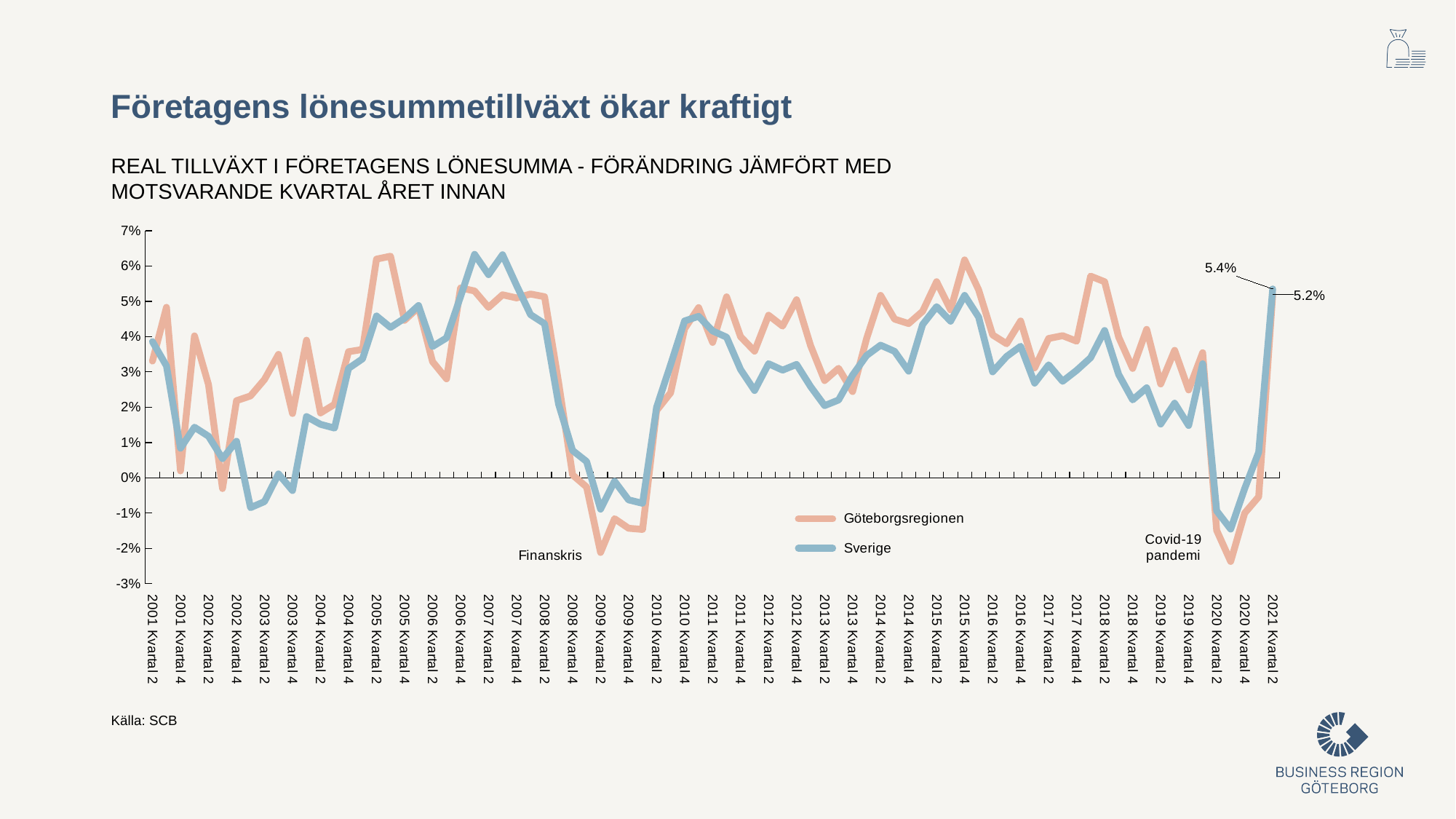
At 2020 Kvartal 2, which series has the lower value, Göteborgsregionen or Sverige? Göteborgsregionen Is the value for Sverige at 2020 Kvartal 2 greater or less than 0%? less What is the higher of the two values labelled at the end of the lines (2021 Kvartal 2)? 5.4% What kind of chart is shown on the slide? Line chart Is the value for Göteborgsregionen at 2020 Kvartal 2 greater or less than 0%? less How many series does the legend list? 2 What two events are annotated on the chart? Finanskris and Covid-19 pandemi What is the lower of the two values labelled at the end of the lines (2021 Kvartal 2)? 5.2% Is the value for Göteborgsregionen at 2009 Kvartal 2 greater or less than -1%? less Which two series are listed in the legend? Göteborgsregionen and Sverige Do the values rise or fall between 2020 Kvartal 2 and 2021 Kvartal 2? Rise